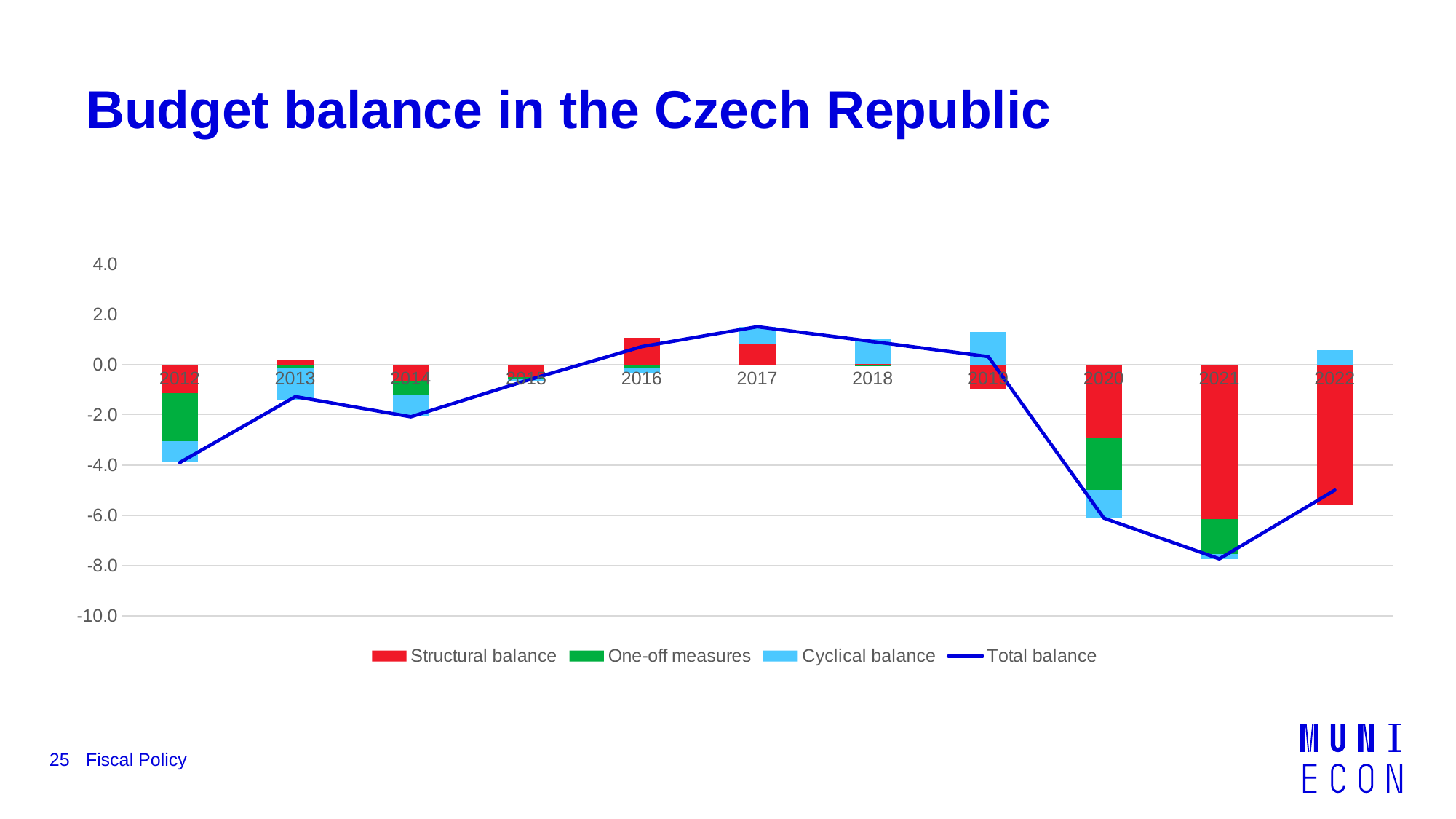
Does the Total balance line rise or fall from 2017 to 2021? fall Which series is drawn as a line rather than bars? Total balance How many years are shown on the x axis? 11 Is the Total balance for 2017 greater or less than 0.0? greater What kind of chart is this? Stacked bar chart with a line Which year has the higher Total balance, 2013 or 2014? 2013 How many series does the legend list? 4 What is the title of the chart? Budget balance in the Czech Republic Is the Total balance for 2021 greater or less than -6.0? less In which year is the Total balance line at its highest? 2017 In which year is the Total balance line at its lowest? 2021 Is the Total balance for 2012 greater or less than -2.0? less